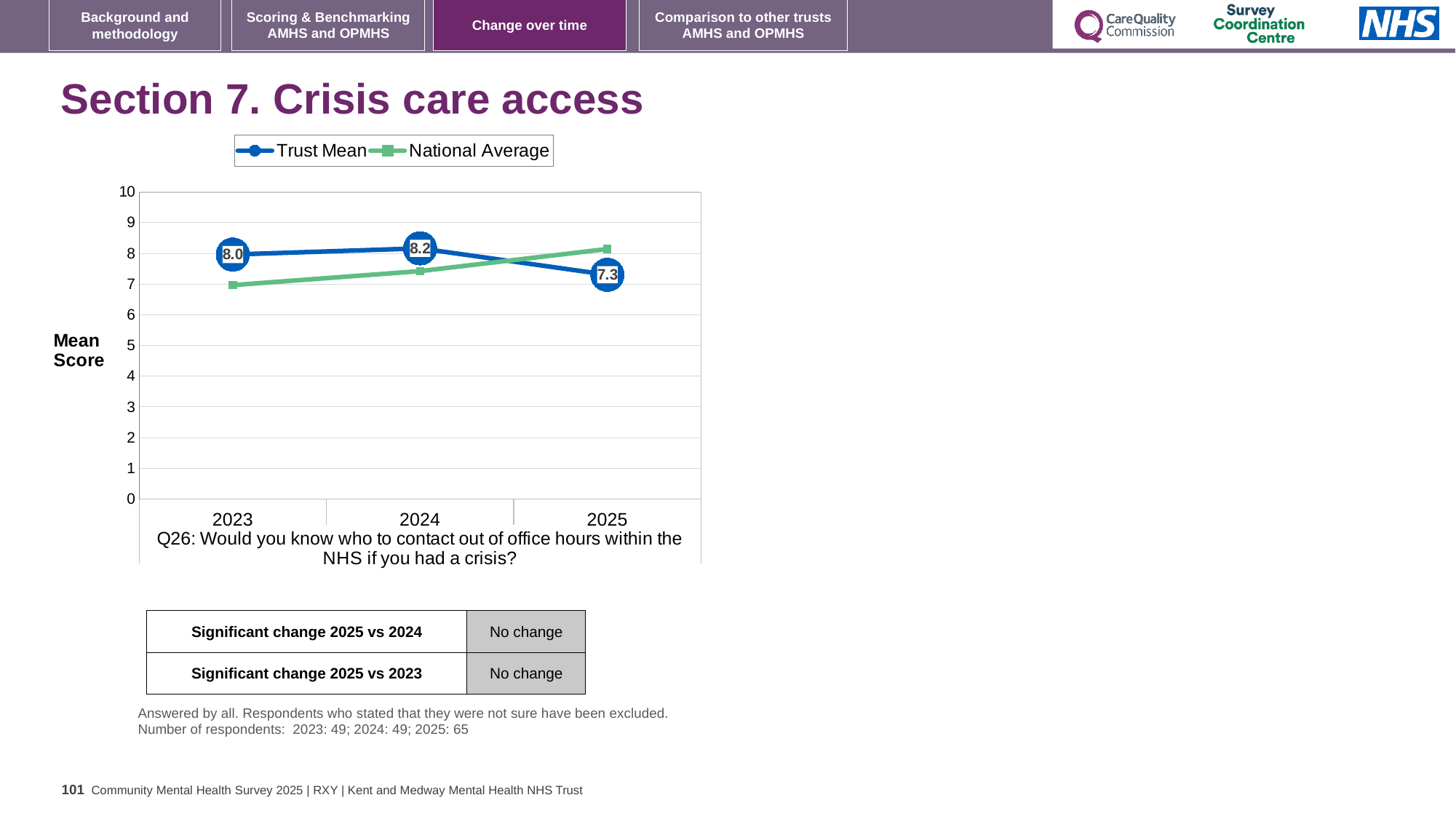
In which year is the Trust Mean highest? 2024 What kind of chart is shown on the slide? Line chart What is the difference between the Trust Mean in 2024 and in 2025? 0.9 How many years are shown on the x axis? 3 In which year is the Trust Mean lowest? 2025 What is the Trust Mean score for 2024? 8.2 Does the National Average rise or fall from 2023 to 2025? Rise Is the National Average value for 2023 greater or less than 8? less How many series does the legend list? 2 What is the Trust Mean score for 2023? 8.0 What is the Trust Mean score for 2025? 7.3 In 2025, which is higher: the Trust Mean or the National Average? National Average